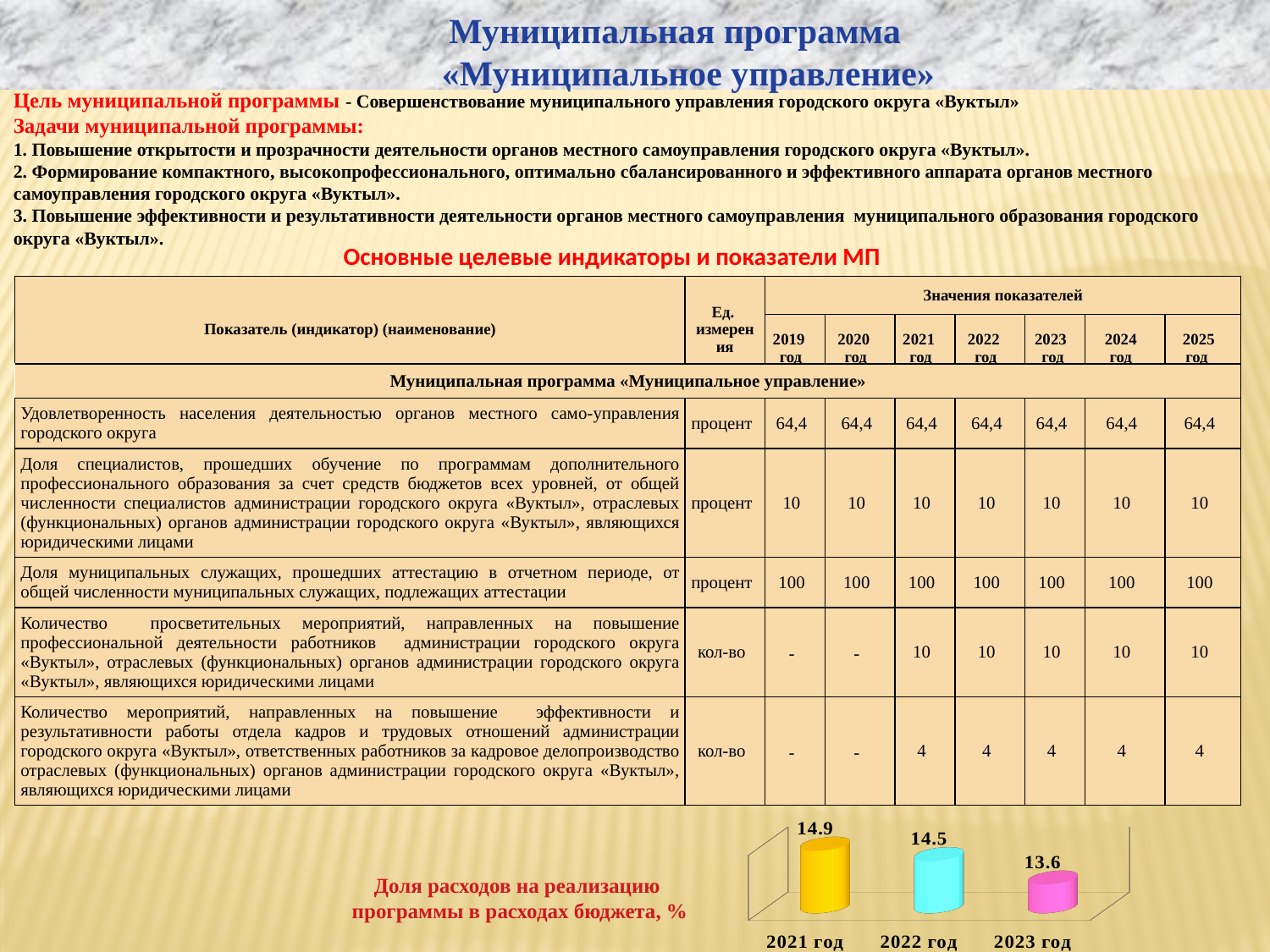
What colour is the bar for 2023 год in the chart? pink What is the difference between the values for 2021 год and 2022 год in the chart? 0.4 Do the values in the chart rise or fall from 2021 год to 2023 год? fall What is the value for 2021 год in the chart? 14.9 What is the difference between the values for 2021 год and 2023 год in the chart? 1.3 Which year has the lowest value in the chart? 2023 год How many bars are shown in the chart? 3 What kind of chart is shown at the bottom of the slide? bar chart Which is larger in the chart: the value for 2022 год or the value for 2023 год? 2022 год Which year has the highest value in the chart? 2021 год What is the value for 2022 год in the chart? 14.5 What is the value for 2023 год in the chart? 13.6